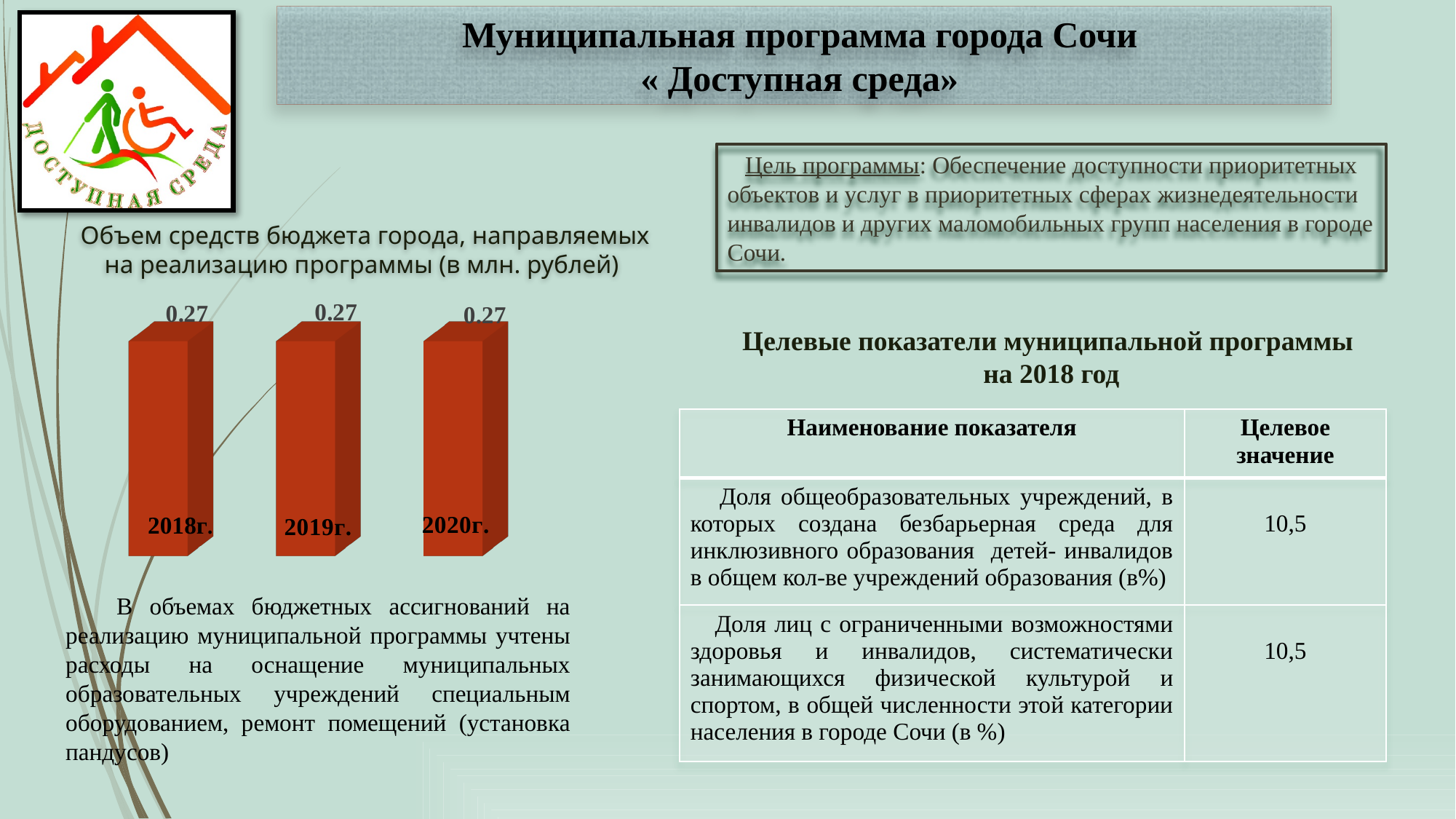
What is the difference between the values for 2018г. and 2020г.? 0 How many bars (years) are shown in the chart? 3 What is the value for 2018г. in the chart? 0.27 What is the value for 2020г. in the chart? 0.27 What kind of chart is shown on the slide? Bar chart What is the title of the chart? Объем средств бюджета города, направляемых на реализацию программы (в млн. рублей) Is the value for 2019г. greater or less than 1? less In what units are the chart values expressed, according to the chart title? млн. рублей Do the values rise, fall, or stay the same from 2018г. to 2020г.? Stay the same What is the value for 2019г. in the chart? 0.27 What is the difference between the values for 2019г. and 2020г.? 0